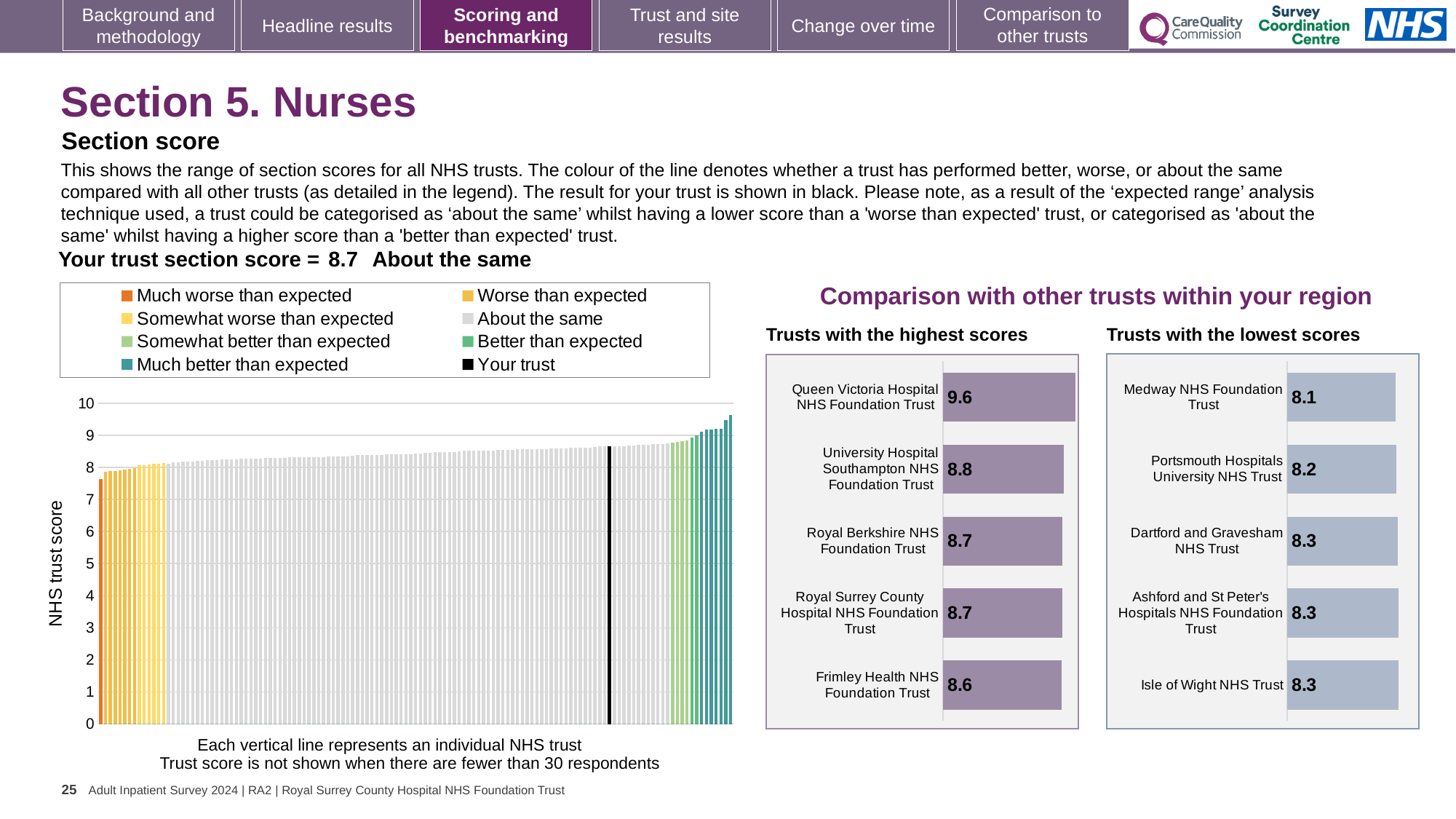
What kind of chart is the large chart on the left showing NHS trust scores? Bar chart In the 'Trusts with the lowest scores' chart, what is the score for Dartford and Gravesham NHS Trust? 8.3 How many trusts are shown in the 'Trusts with the highest scores' chart? 5 In the 'Trusts with the lowest scores' chart, which trust has the lowest score? Medway NHS Foundation Trust In the 'Trusts with the lowest scores' chart, what is the difference between the scores of Portsmouth Hospitals University NHS Trust and Medway NHS Foundation Trust? 0.1 In the 'Trusts with the highest scores' chart, what is the difference between the scores of Queen Victoria Hospital NHS Foundation Trust and Frimley Health NHS Foundation Trust? 1.0 In the 'Trusts with the highest scores' chart, what is the score for Frimley Health NHS Foundation Trust? 8.6 In the 'Trusts with the lowest scores' chart, which has the larger score: Medway NHS Foundation Trust or Portsmouth Hospitals University NHS Trust? Portsmouth Hospitals University NHS Trust How many entries does the legend above the large chart on the left list? 8 In the 'Trusts with the highest scores' chart, which trust has the highest score? Queen Victoria Hospital NHS Foundation Trust In the large chart on the left, do the trust scores rise or fall from left to right? Rise In the 'Trusts with the highest scores' chart, what is the score for Queen Victoria Hospital NHS Foundation Trust? 9.6